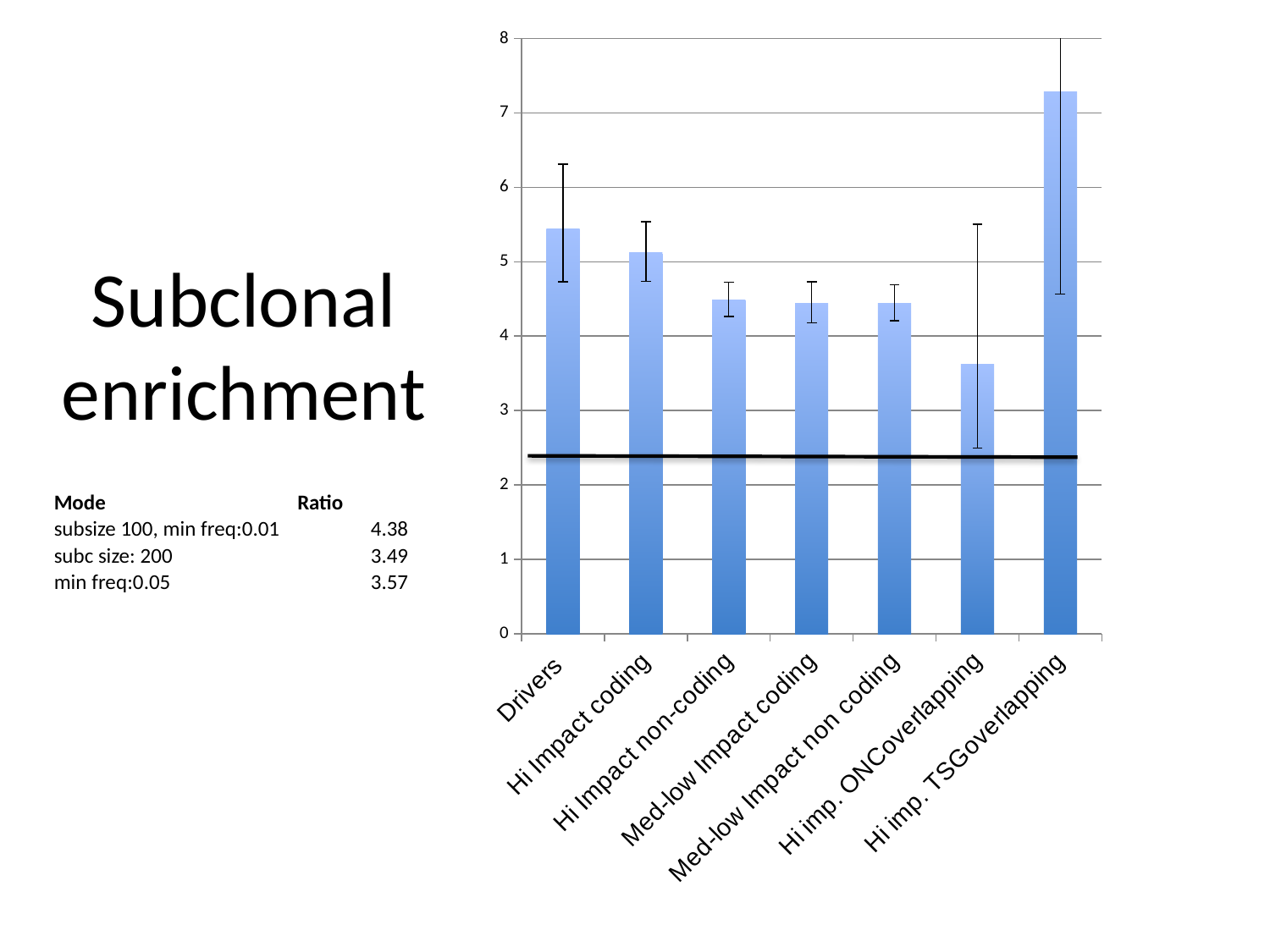
What is the maximum value shown on the y axis of the chart? 8 Is the value for Hi Impact non-coding greater or less than 4? greater Is the value for Hi imp. TSGoverlapping greater or less than 7? greater Which category has the lowest bar in the chart? Hi imp. ONCoverlapping Which is larger, the value for Hi imp. TSGoverlapping or the value for Hi Impact coding? Hi imp. TSGoverlapping What kind of chart is shown on the slide? bar chart Which is larger, the value for Drivers or the value for Hi imp. ONCoverlapping? Drivers Is the value for Drivers greater or less than 5? greater How many categories are plotted on the x axis of the chart? 7 Is the horizontal black line across the chart above or below the 3 gridline? below Which category has the highest bar in the chart? Hi imp. TSGoverlapping